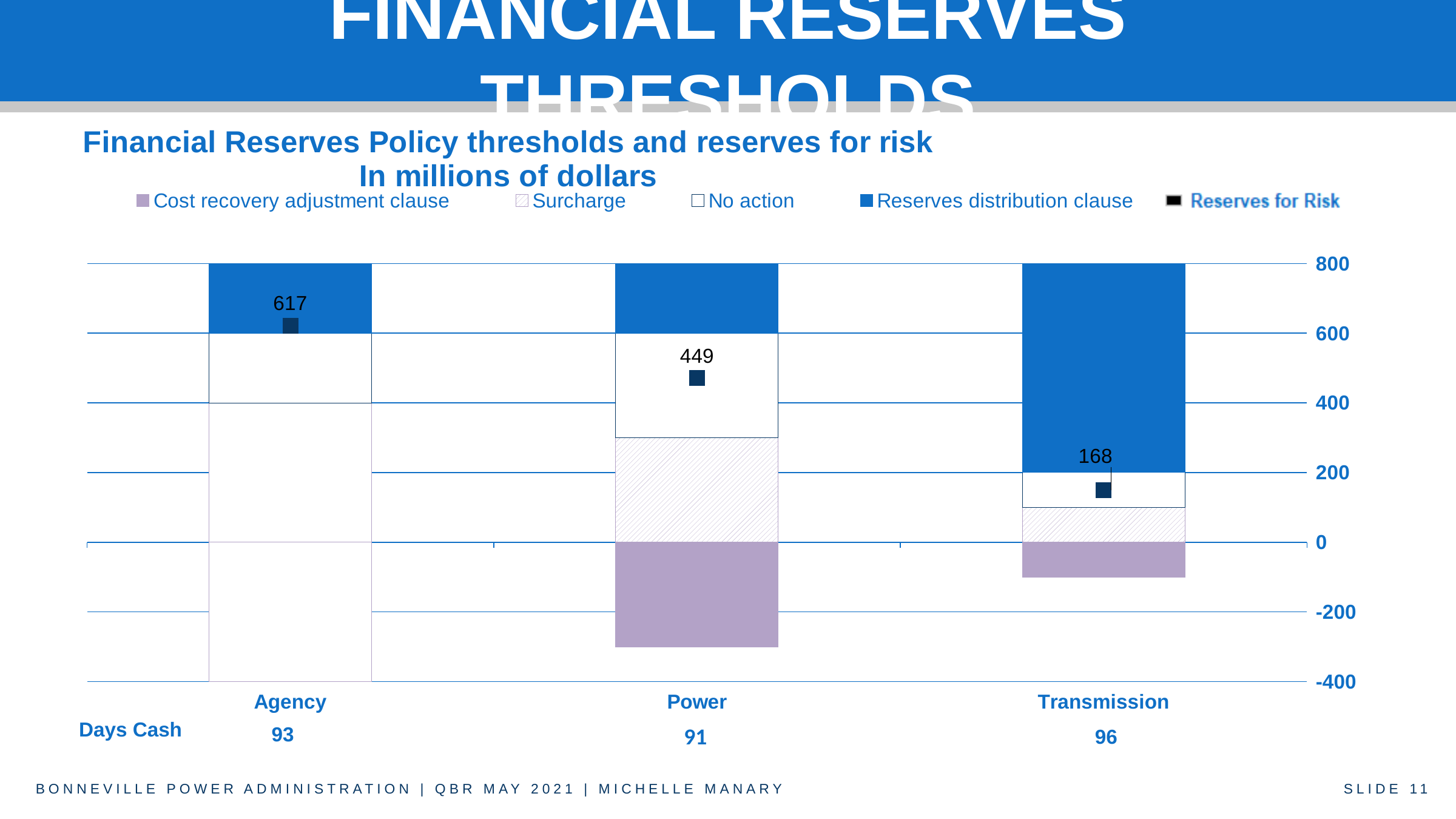
How many series does the chart legend list? 5 Which has a larger Reserves for Risk value, Power or Transmission? Power Is the upper boundary of the Surcharge segment for Power greater or less than 200? greater What is the Reserves for Risk value for Agency? 617 What is the Reserves for Risk value for Transmission? 168 What kind of chart is shown on the slide? Stacked bar chart What is the difference between the Reserves for Risk values for Power and Transmission? 281 Which category has the highest Reserves for Risk value? Agency How many categories are shown on the x axis of the chart? 3 What is the difference between the Reserves for Risk values for Agency and Power? 168 What is the Reserves for Risk value for Power? 449 Which category has the lowest Reserves for Risk value? Transmission